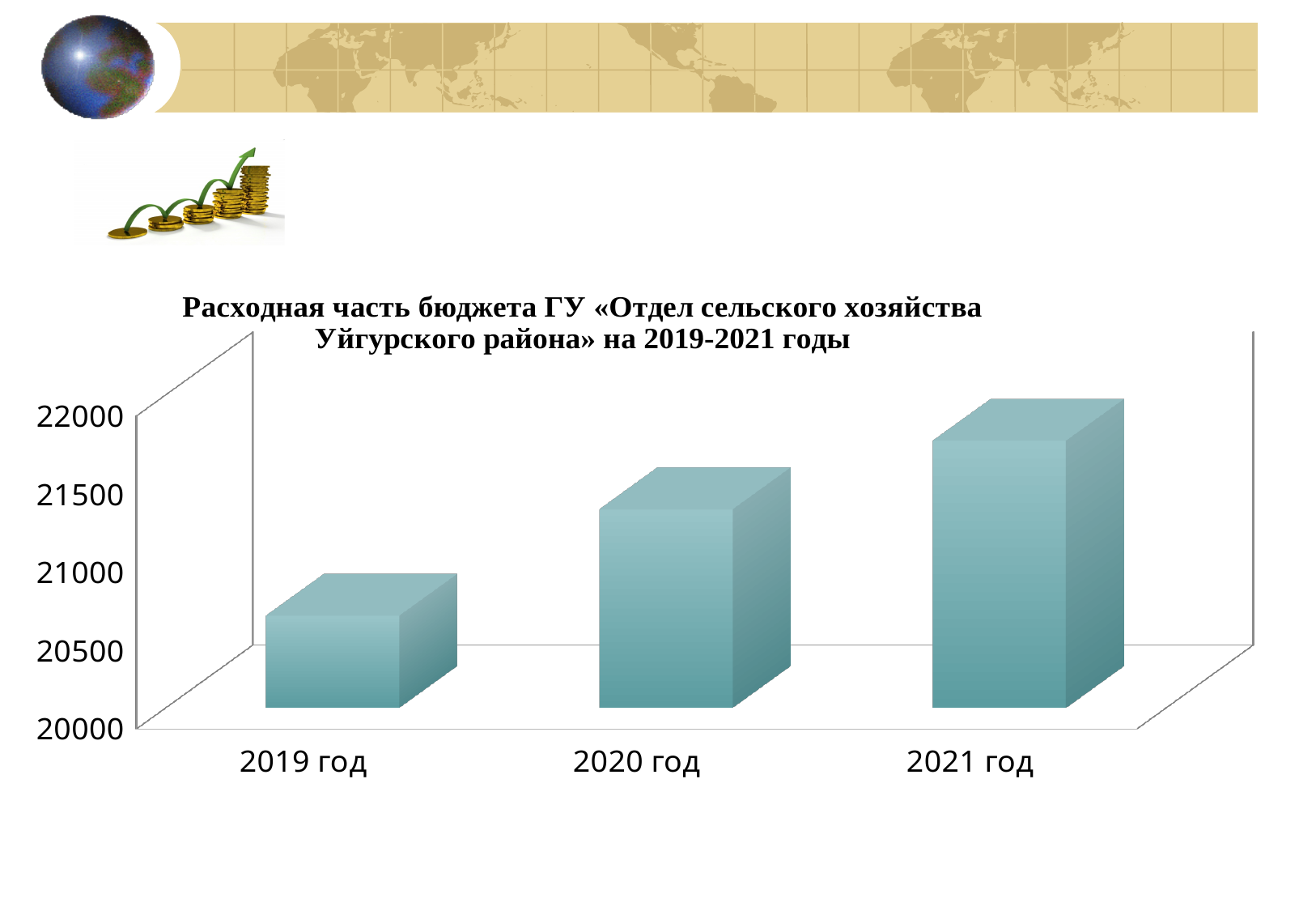
How many categories (years) are shown on the x axis of the chart? 3 Do the values rise or fall from 2019 год to 2021 год? rise What years does the chart title say the budget expenditure covers? 2019-2021 годы What kind of chart is shown on the slide? bar chart Is the value for 2019 год greater or less than 21000? less Is the value for 2021 год greater or less than 21500? greater Which is larger, the value for 2021 год or the value for 2020 год? 2021 год Is the value for 2020 год greater or less than 21000? greater Which year has the lowest value in the chart? 2019 год Which year has the highest value in the chart? 2021 год Which is larger, the value for 2020 год or the value for 2019 год? 2020 год What is the lowest value shown on the vertical axis of the chart? 20000